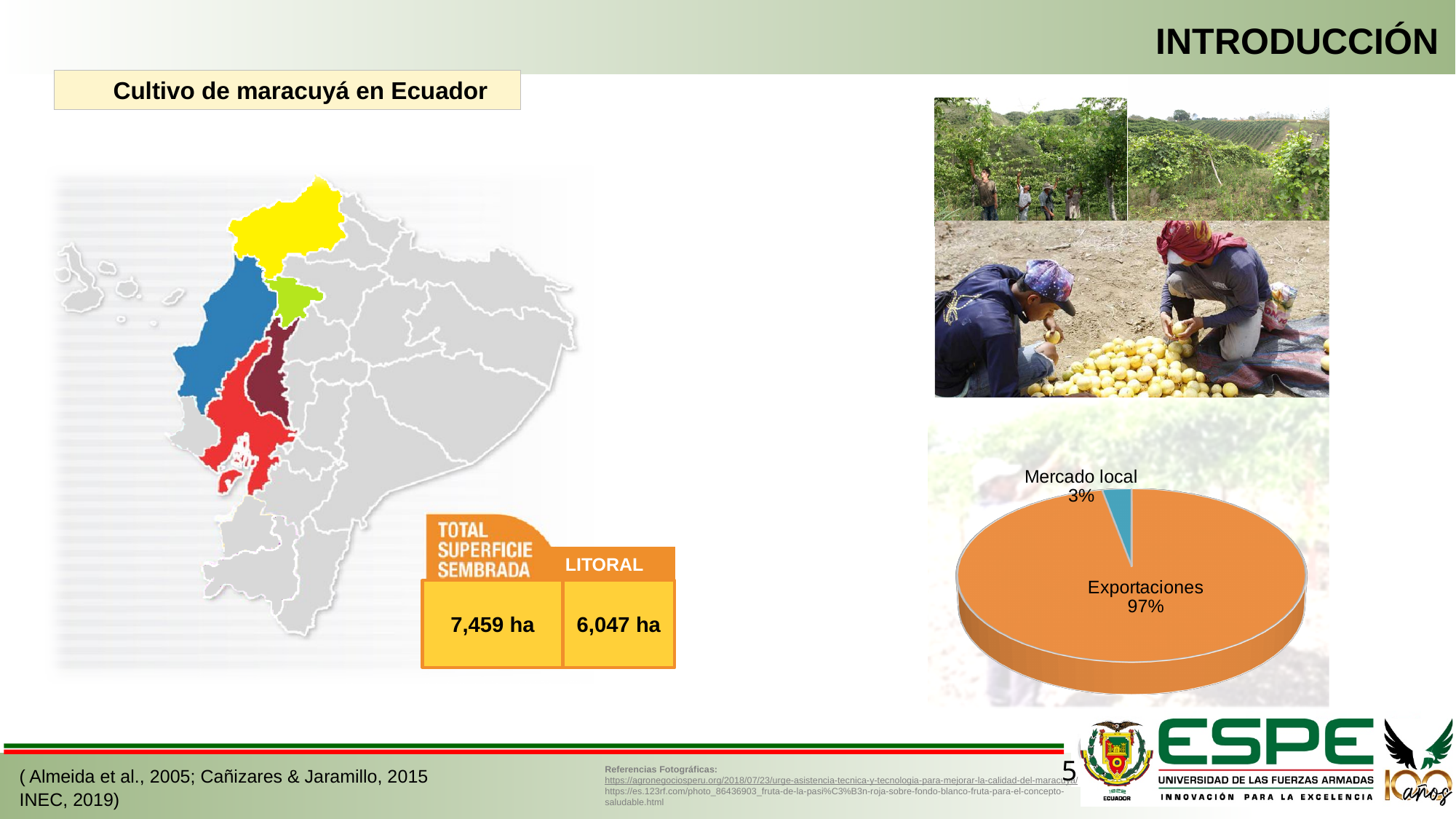
In the pie chart, which is larger: Exportaciones or Mercado local? Exportaciones What kind of chart is shown on the right side of the slide? pie chart In the pie chart, what is the difference in percentage points between Exportaciones and Mercado local? 94 Which slice of the pie chart is the smallest? Mercado local Which slice of the pie chart is the largest? Exportaciones How many slices does the pie chart have? 2 In the pie chart, what share is labelled for Mercado local? 3% In the pie chart, what share is labelled for Exportaciones? 97% What colour is the Exportaciones slice in the pie chart? orange What colour is the Mercado local slice in the pie chart? blue